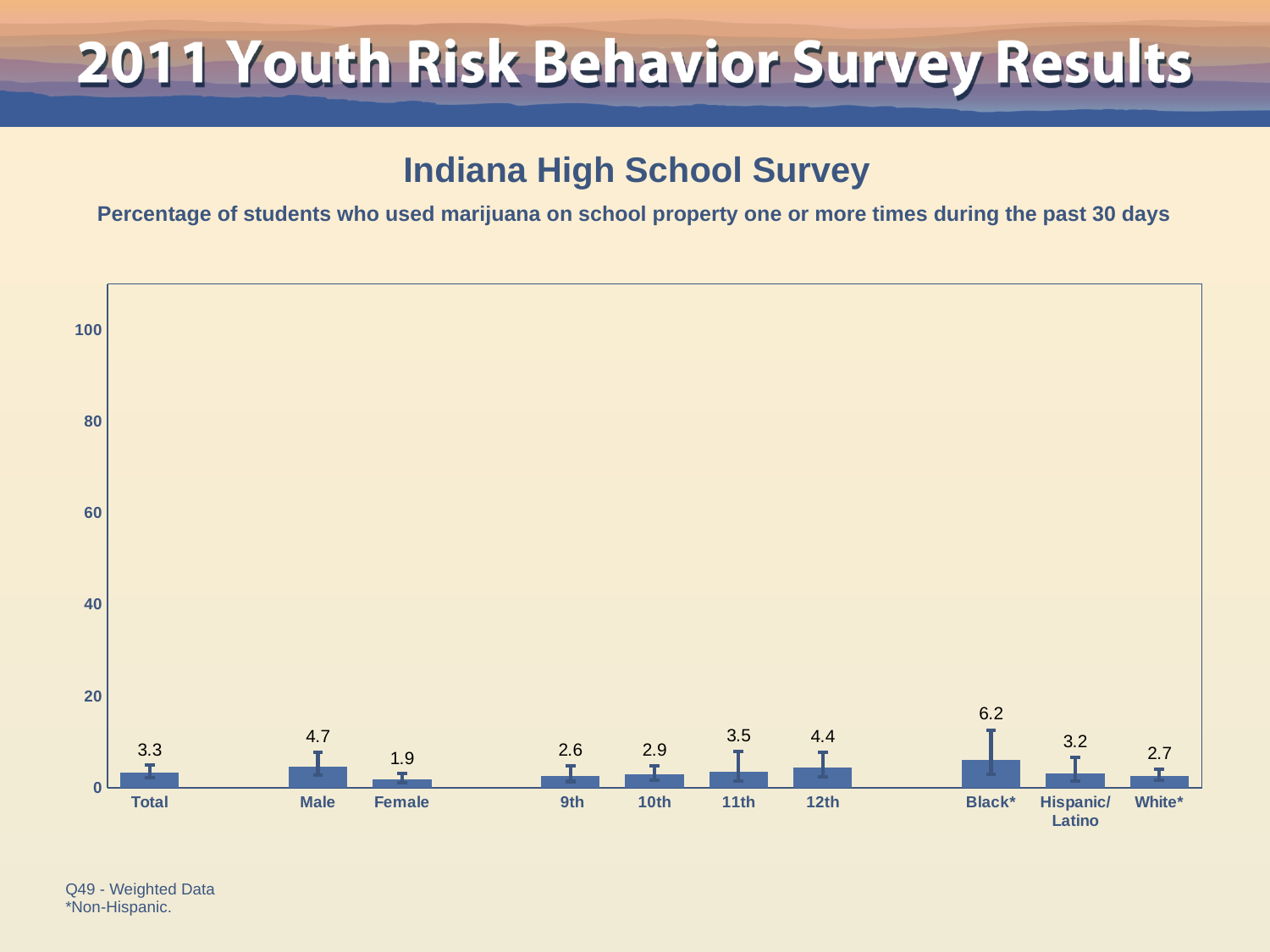
What is the difference between the values for Male and Female? 2.8 Is the value for Black* greater or less than 20? less Do the values rise or fall from 9th to 12th grade? rise How many categories are shown on the x axis? 10 What is the value for Hispanic/Latino? 3.2 Which category has the highest value? Black* Which is larger, the value for 11th or the value for 12th? 12th Which category has the lowest value? Female What is the subtitle describing what the chart measures? Percentage of students who used marijuana on school property one or more times during the past 30 days What is the value for Male? 4.7 What kind of chart is this? bar chart What is the value for Total? 3.3